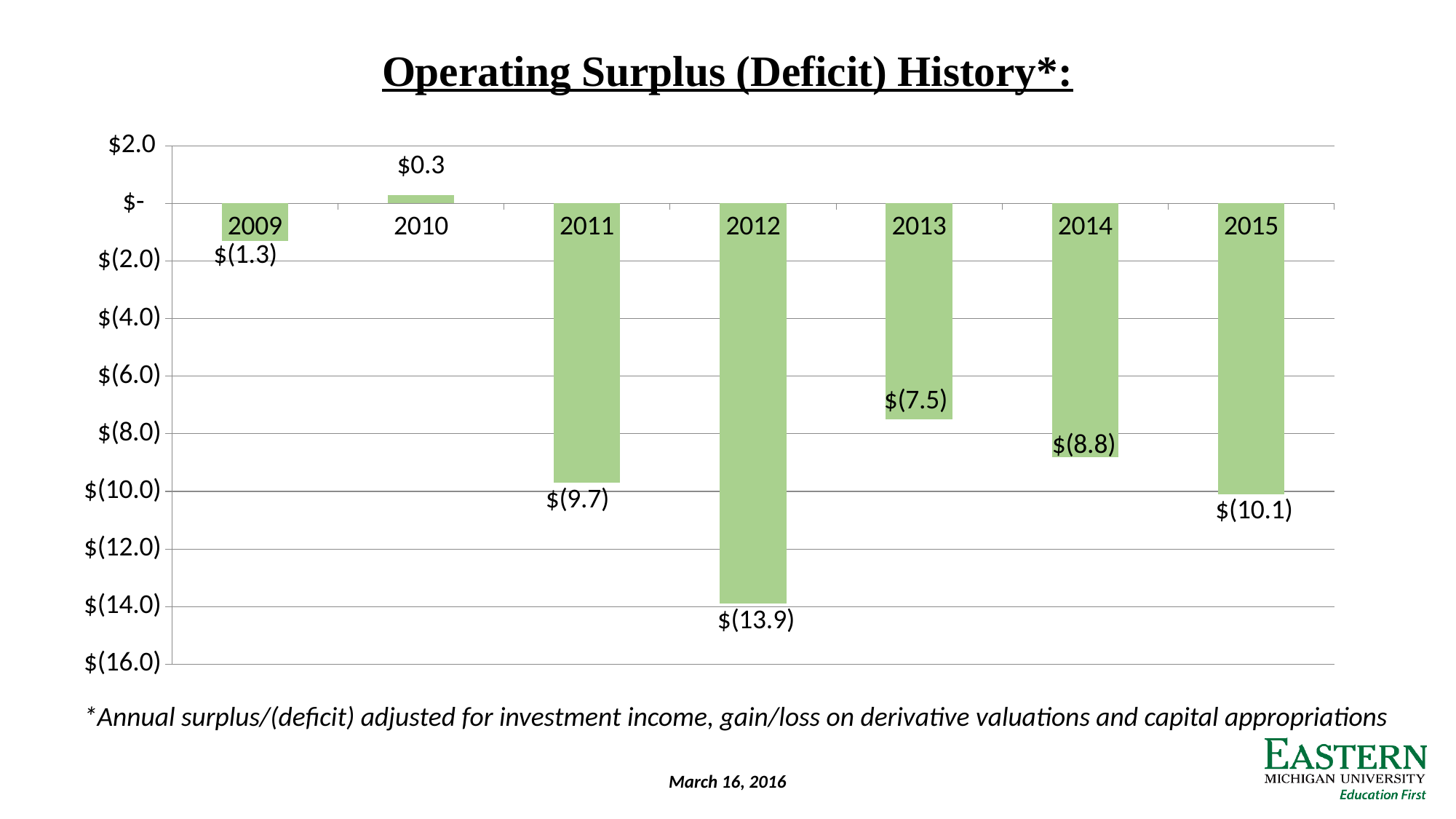
Which year has the largest deficit (lowest value)? 2012 What is the value shown for 2009? $(1.3) Which year has the highest value? 2010 What is the title of the chart? Operating Surplus (Deficit) History*: What is the operating surplus (deficit) value shown for 2012? $(13.9) What is the value shown for 2010? $0.3 What is the value shown for 2015? $(10.1) What type of chart is shown on the slide? bar chart What is the difference between the 2012 value and the 2011 value? $4.2 Which year is the only one showing a surplus (positive value)? 2010 Is the deficit for 2014 larger or smaller than the deficit for 2013? larger How many years are shown on the chart? 7